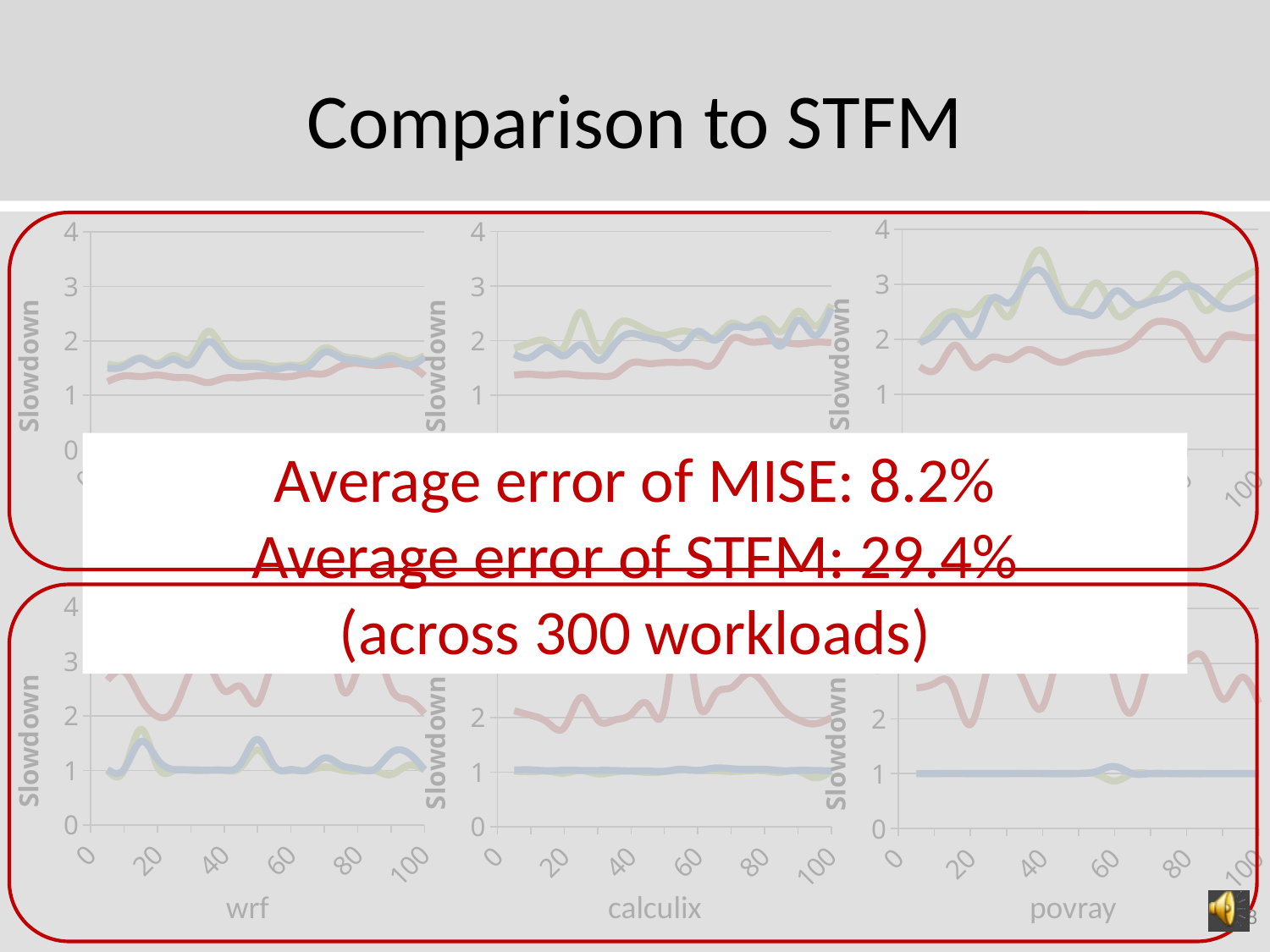
In the top-right chart, is the red line greater or less than 3? less In the bottom-right chart (povray), which line has the highest values, the red line or the blue line? Red line What is the y-axis label on the charts? Slowdown How many lines are plotted in the bottom-left chart (wrf)? 3 What kind of charts are shown on the slide? Line charts In the top-right chart, does the blue line generally rise or fall from left to right? Rise In the bottom-middle chart (calculix), is the blue line greater or less than 2? less What is the title of the slide? Comparison to STFM In the bottom-middle chart (calculix), is the red line greater or less than 1? greater How many charts are shown on the slide? 6